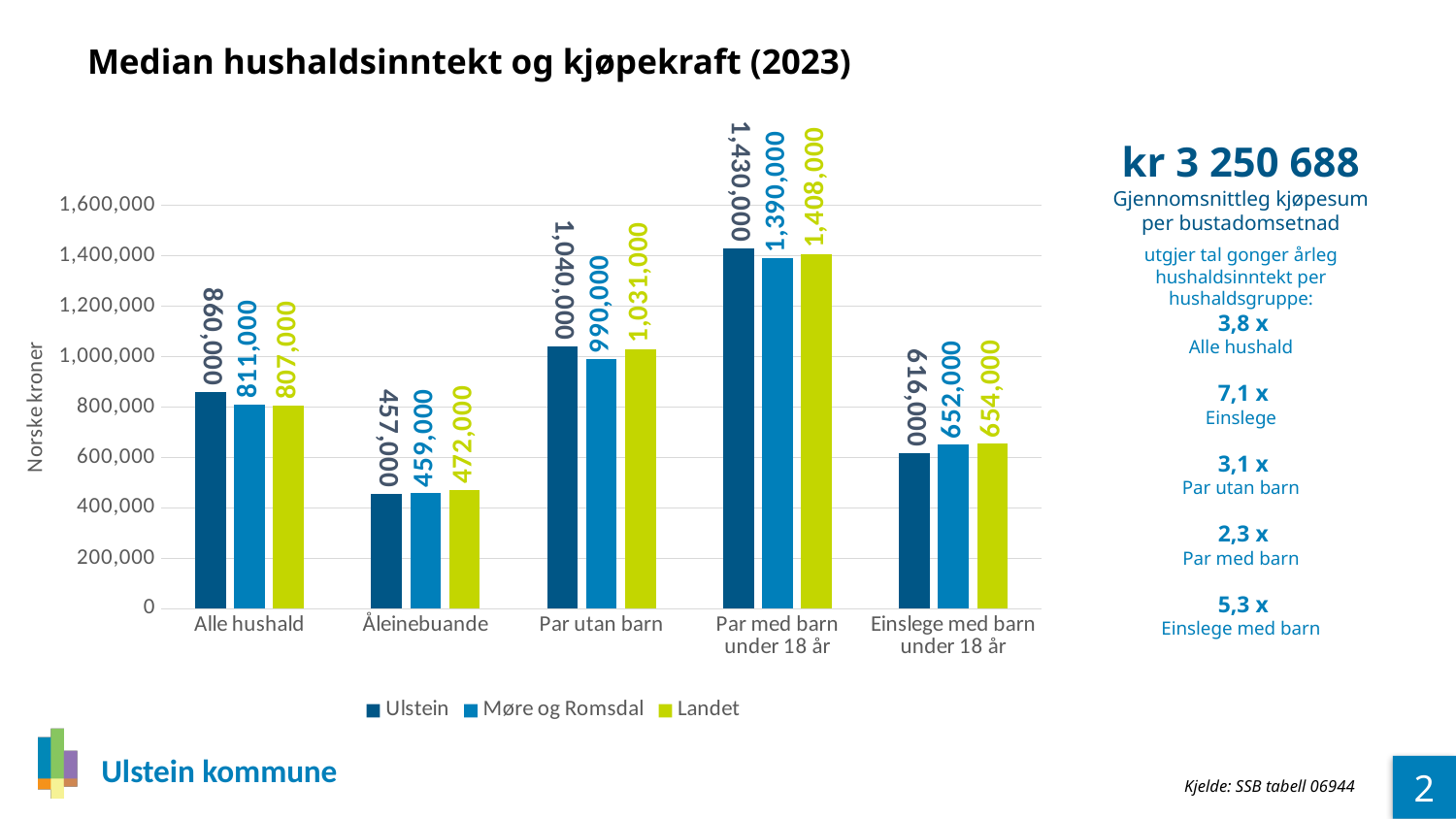
In the 'Einslege med barn under 18 år' category, which is larger: Ulstein or Landet? Landet How many series does the legend list? 3 What is the difference between the Ulstein and Møre og Romsdal values in the 'Par utan barn' category? 50,000 What is the label on the y axis of the chart? Norske kroner What is the value for Ulstein in the 'Einslege med barn under 18 år' category? 616,000 Which category has the highest value for the Ulstein series? Par med barn under 18 år What is the median household income for Ulstein in the 'Alle hushald' category? 860,000 What is the value for Møre og Romsdal in the 'Åleinebuande' category? 459,000 How many household categories are shown on the x axis? 5 What is the value for Landet in the 'Par med barn under 18 år' category? 1,408,000 What type of chart is shown on the slide? Bar chart Which category has the lowest value for the Landet series? Åleinebuande